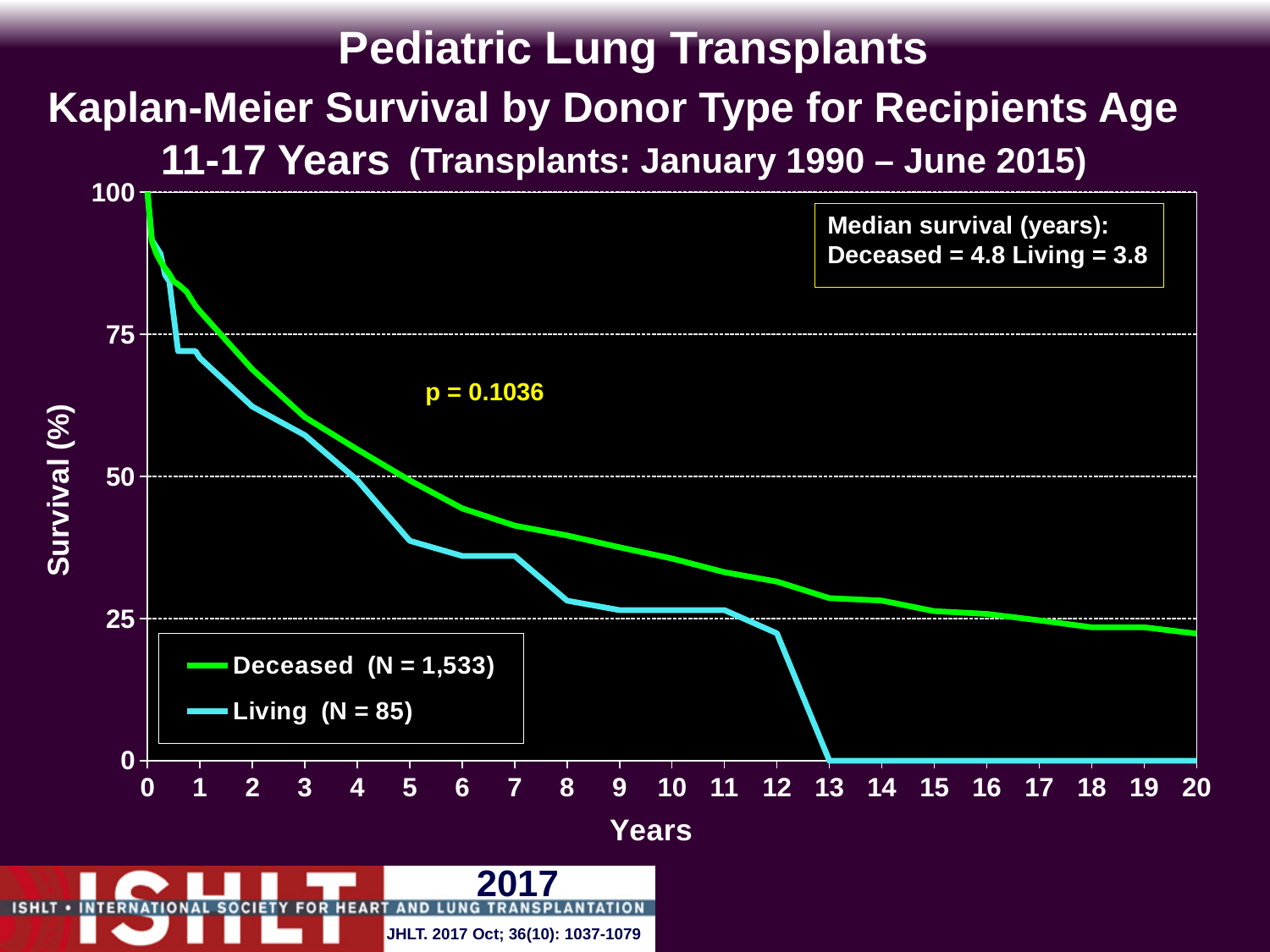
What is the p-value shown on the chart? 0.1036 Do the survival curves rise or fall as years increase? fall What is the N for the Living donor group shown in the legend? 85 What is the survival value for the Living group at 15 years? 0 What is the median survival in years for the Living donor group? 3.8 Is the survival value for the Living group at 5 years greater or less than 50? less What is the median survival in years for the Deceased donor group? 4.8 Is the survival value for the Deceased group at 10 years greater or less than 50? less How many series does the legend list? 2 At 10 years, which group has the higher survival, Deceased or Living? Deceased What is the N for the Deceased donor group shown in the legend? 1,533 What kind of chart is shown on the slide? line chart